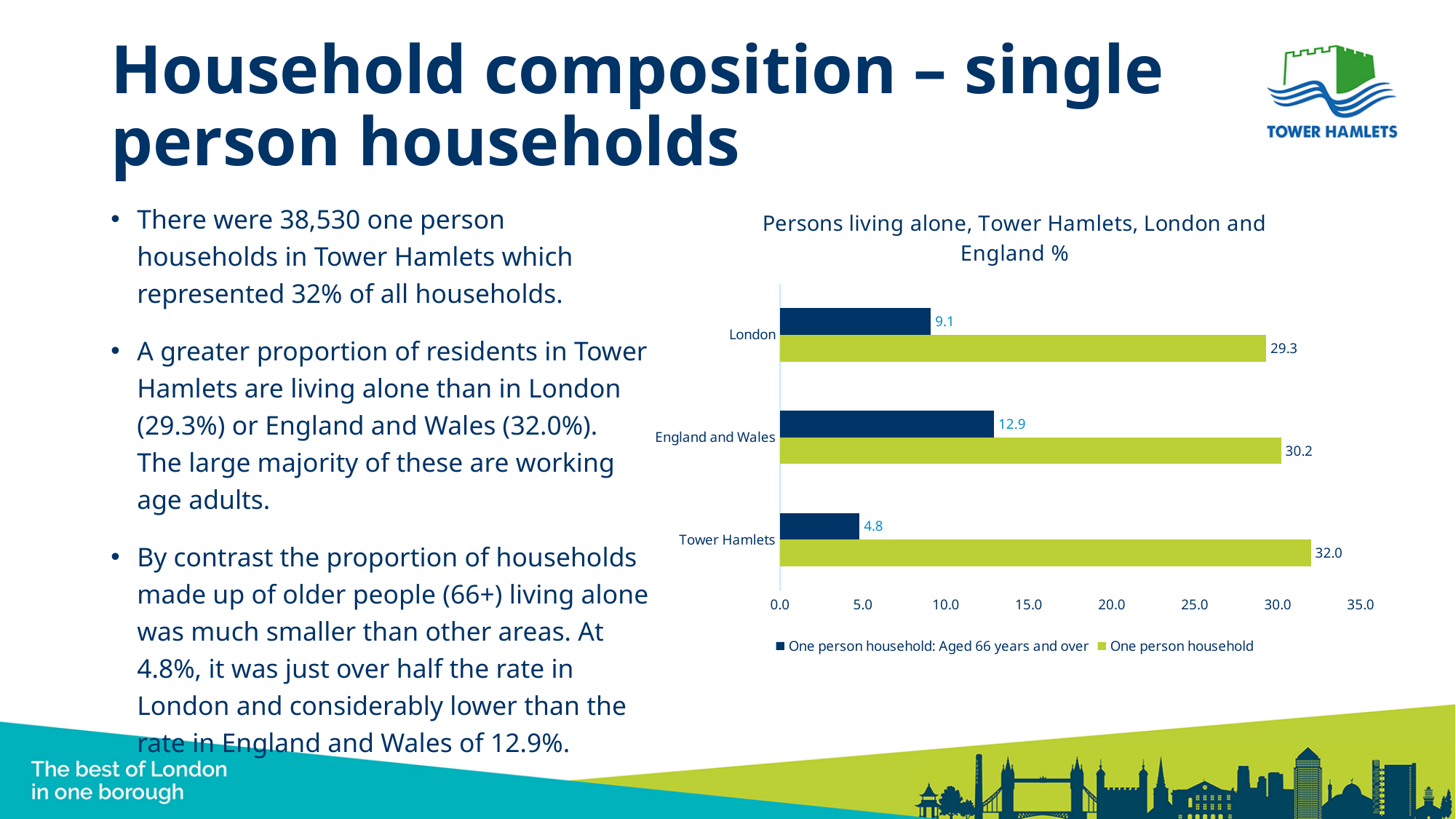
How many areas are shown on the chart? 3 What is the difference between the 'One person household' values for Tower Hamlets and London? 2.7 Which is larger: the 'One person household: Aged 66 years and over' value for London or for England and Wales? England and Wales Which area has the lowest value for 'One person household: Aged 66 years and over'? Tower Hamlets What is the value for 'One person household: Aged 66 years and over' for London? 9.1 What kind of chart is shown on the slide? Bar chart What is the title of the chart? Persons living alone, Tower Hamlets, London and England % What is the difference between the 'One person household: Aged 66 years and over' values for England and Wales and Tower Hamlets? 8.1 Which area has the highest value for 'One person household'? Tower Hamlets What is the value for 'One person household: Aged 66 years and over' for England and Wales? 12.9 How many series does the legend list? 2 What is the value for 'One person household' for Tower Hamlets? 32.0